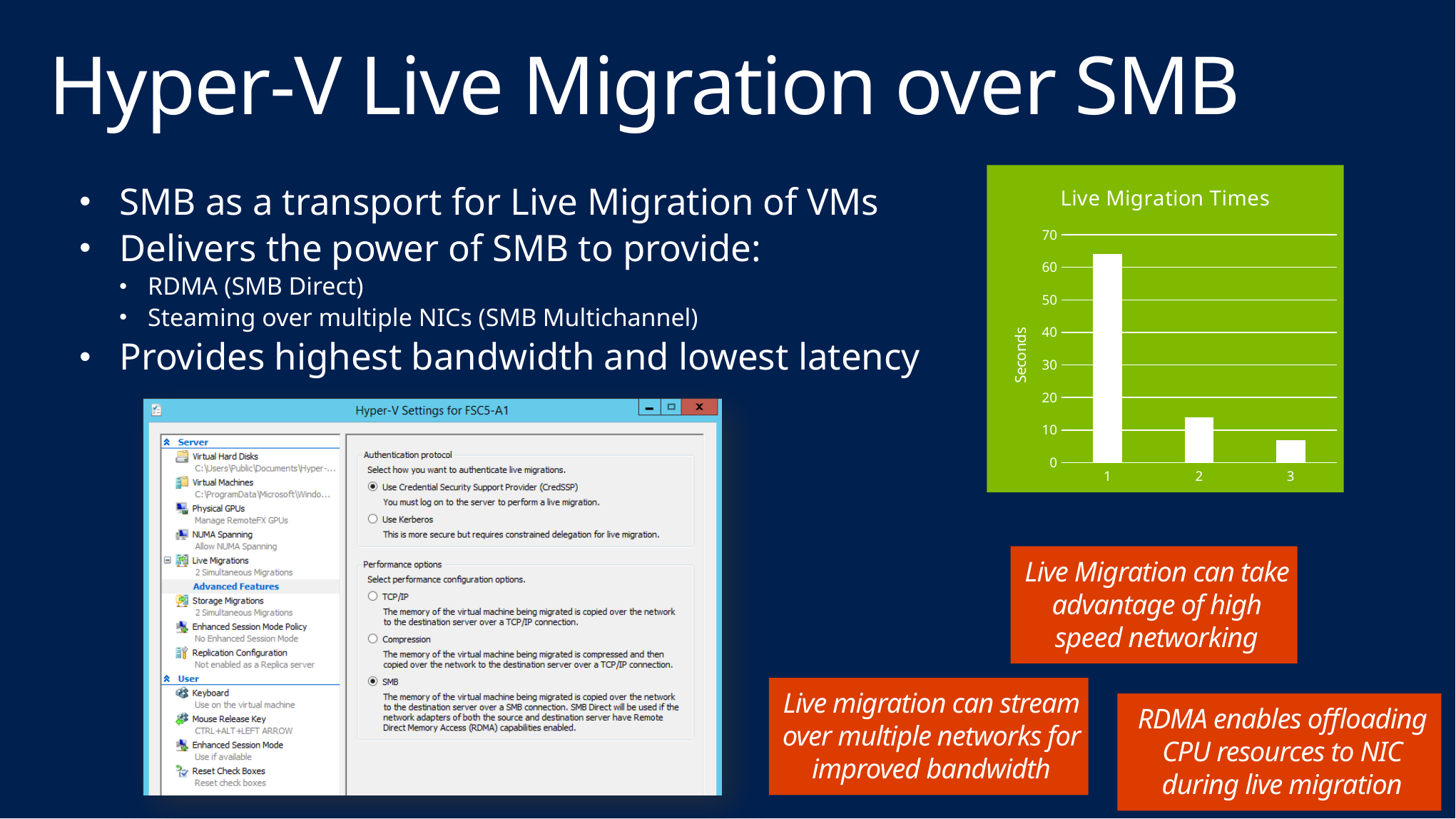
Which category has the highest value in the Live Migration Times chart? 1 What is the title of the chart? Live Migration Times Is the value for category 3 greater or less than 10? less Which category has the lowest value in the Live Migration Times chart? 3 Which is larger in the Live Migration Times chart, the value for category 2 or category 3? 2 What is the label on the vertical axis of the chart? Seconds What is the highest tick value shown on the vertical axis of the chart? 70 How many bars are plotted in the Live Migration Times chart? 3 What kind of chart is shown on the slide? bar chart Is the value for category 2 greater or less than 20? less Do the values in the Live Migration Times chart rise or fall from category 1 to category 3? fall Is the value for category 1 greater or less than 60? greater